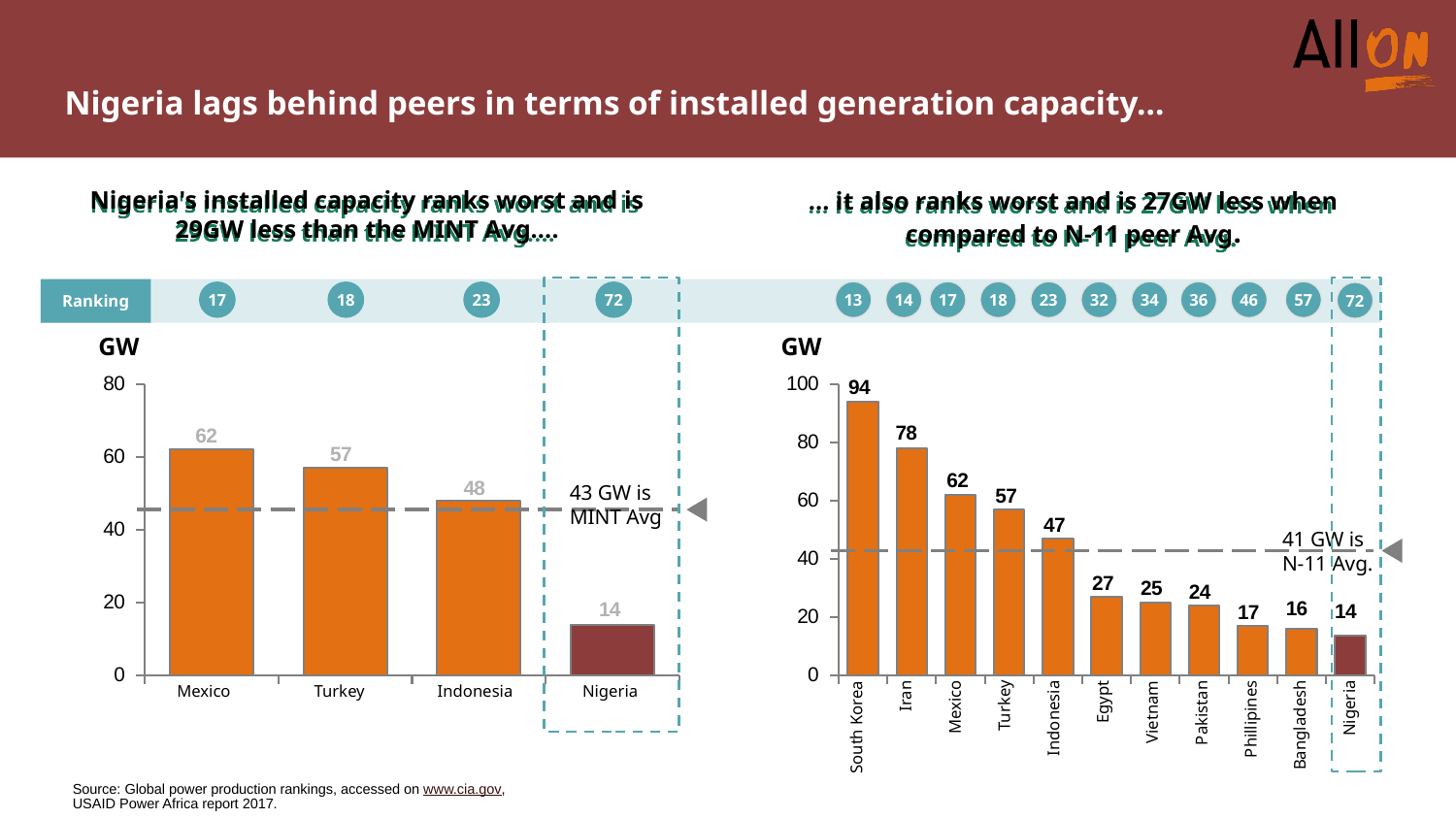
What type of chart is the right chart (N-11 comparison)? Bar chart In the left chart (MINT comparison), what value is shown as the MINT Avg? 43 GW In the right chart (N-11 comparison), what is the difference in GW between Iran and Indonesia? 31 In the left chart (MINT comparison), how many countries are plotted? 4 In the left chart (MINT comparison), what is the difference in GW between Mexico and Nigeria? 48 In the left chart (MINT comparison), what is the installed capacity in GW for Indonesia? 48 In the right chart (N-11 comparison), how many countries are plotted? 11 In the right chart (N-11 comparison), what is the installed capacity in GW for South Korea? 94 In the right chart (N-11 comparison), what is the installed capacity in GW for Pakistan? 24 In the left chart (MINT comparison), which country has the highest installed capacity? Mexico In the right chart (N-11 comparison), which has a larger installed capacity, Iran or Egypt? Iran In the right chart (N-11 comparison), which country has the lowest installed capacity? Nigeria